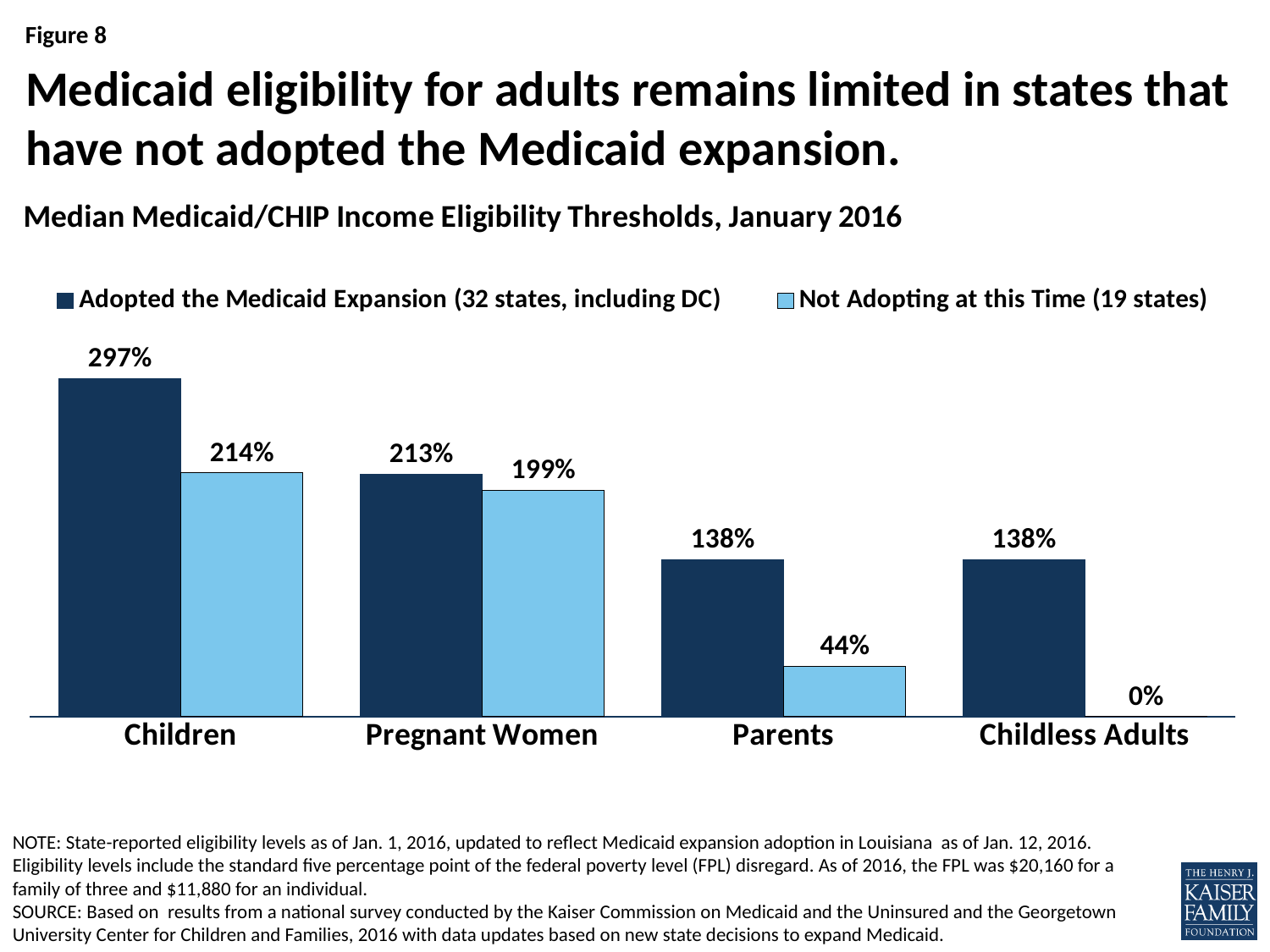
What is the value for Childless Adults in states not adopting the expansion at this time? 0% What is the median income eligibility threshold for Parents in states not adopting the expansion at this time? 44% What is the median income eligibility threshold for Children in states that adopted the Medicaid expansion? 297% Which category has the lowest value for states not adopting the expansion at this time? Childless Adults Which category has the highest value for states that adopted the Medicaid expansion? Children How many categories are shown on the x axis? 4 What is the value for Pregnant Women in states that adopted the Medicaid expansion? 213% What is the difference between the Parents values for expansion states and non-expansion states? 94 percentage points What is the difference between the Children values for expansion states and non-expansion states? 83 percentage points What kind of chart is shown on the slide? Bar chart For Pregnant Women, which group has the larger value: states that adopted the expansion or states not adopting at this time? Adopted the Medicaid Expansion How many series does the legend list? 2